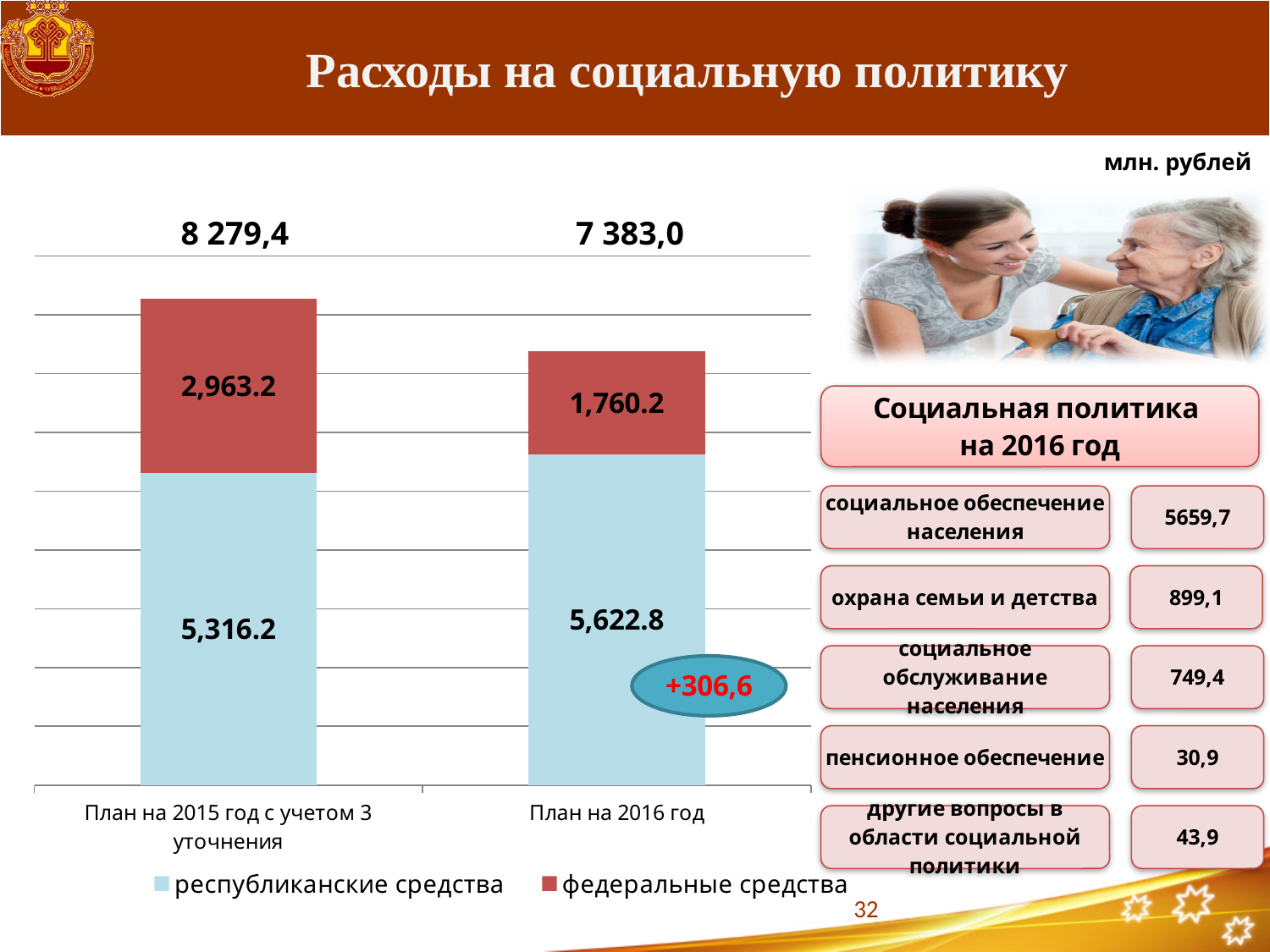
What is the value of республиканские средства for План на 2016 год? 5,622.8 Which category has the larger value for федеральные средства? План на 2015 год с учетом 3 уточнения Which category has the larger value for республиканские средства? План на 2016 год How many categories are shown on the x axis? 2 What is the difference between федеральные средства in План на 2015 год с учетом 3 уточнения and in План на 2016 год? 1,203.0 What is the value of республиканские средства for План на 2015 год с учетом 3 уточнения? 5,316.2 What is the value of федеральные средства for План на 2015 год с учетом 3 уточнения? 2,963.2 How many series does the legend list? 2 What type of chart is shown on the slide? stacked bar chart What is the total shown above the bar for План на 2015 год с учетом 3 уточнения? 8 279,4 What is the value of федеральные средства for План на 2016 год? 1,760.2 What is the total shown above the bar for План на 2016 год? 7 383,0